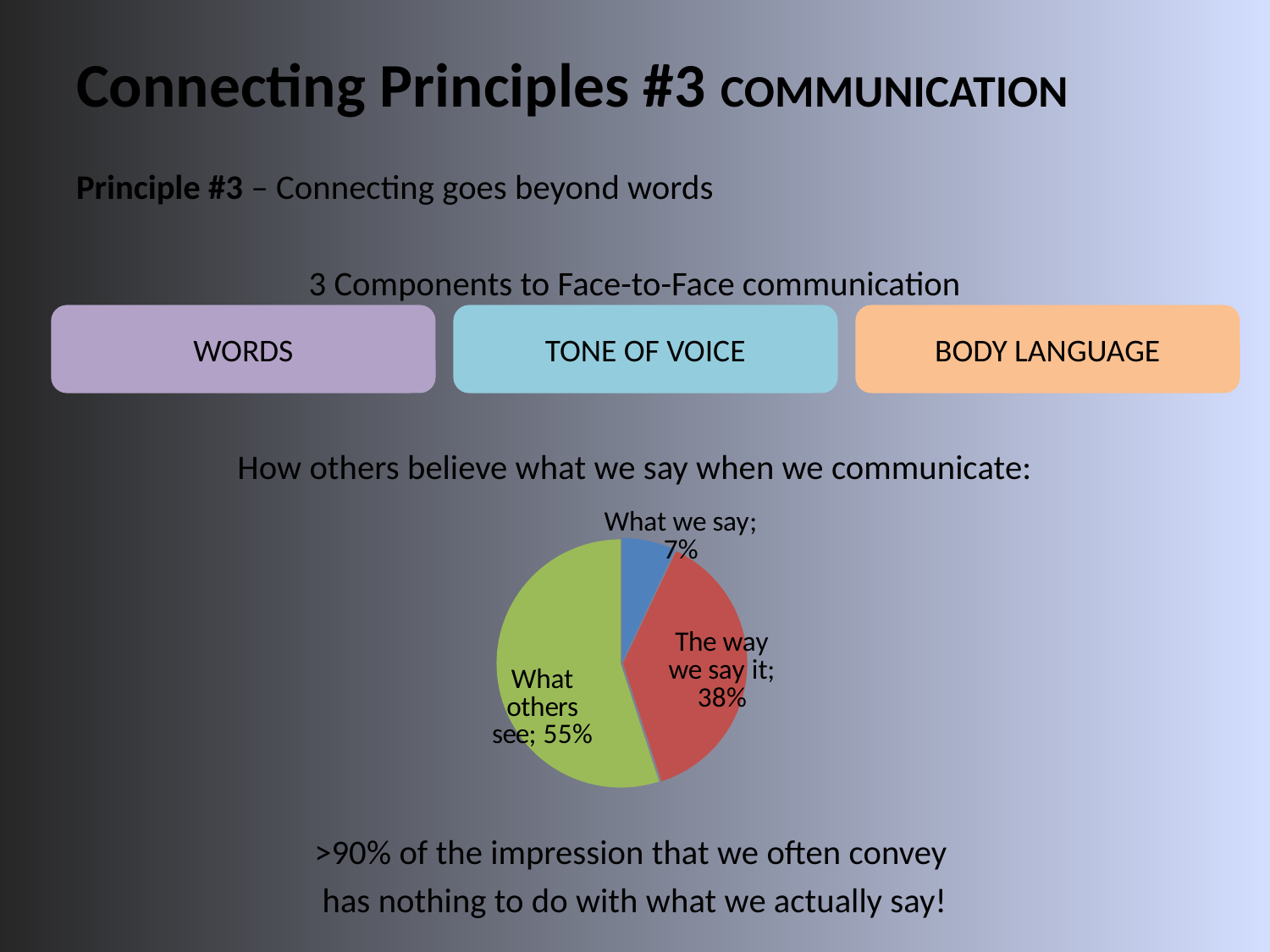
What percentage is shown for "What others see"? 55% What colour is the "What we say" slice? blue Which slice of the pie chart is the smallest? What we say What colour is the "What others see" slice? green How many slices does the pie chart have? 3 Which slice of the pie chart is the largest? What others see What percentage is shown for "The way we say it"? 38% What percentage is shown for "What we say"? 7% What is the difference in percentage points between "What others see" and "The way we say it"? 17 What is the difference in percentage points between "The way we say it" and "What we say"? 31 Which is larger, "The way we say it" or "What we say"? The way we say it What kind of chart is shown on the slide? pie chart